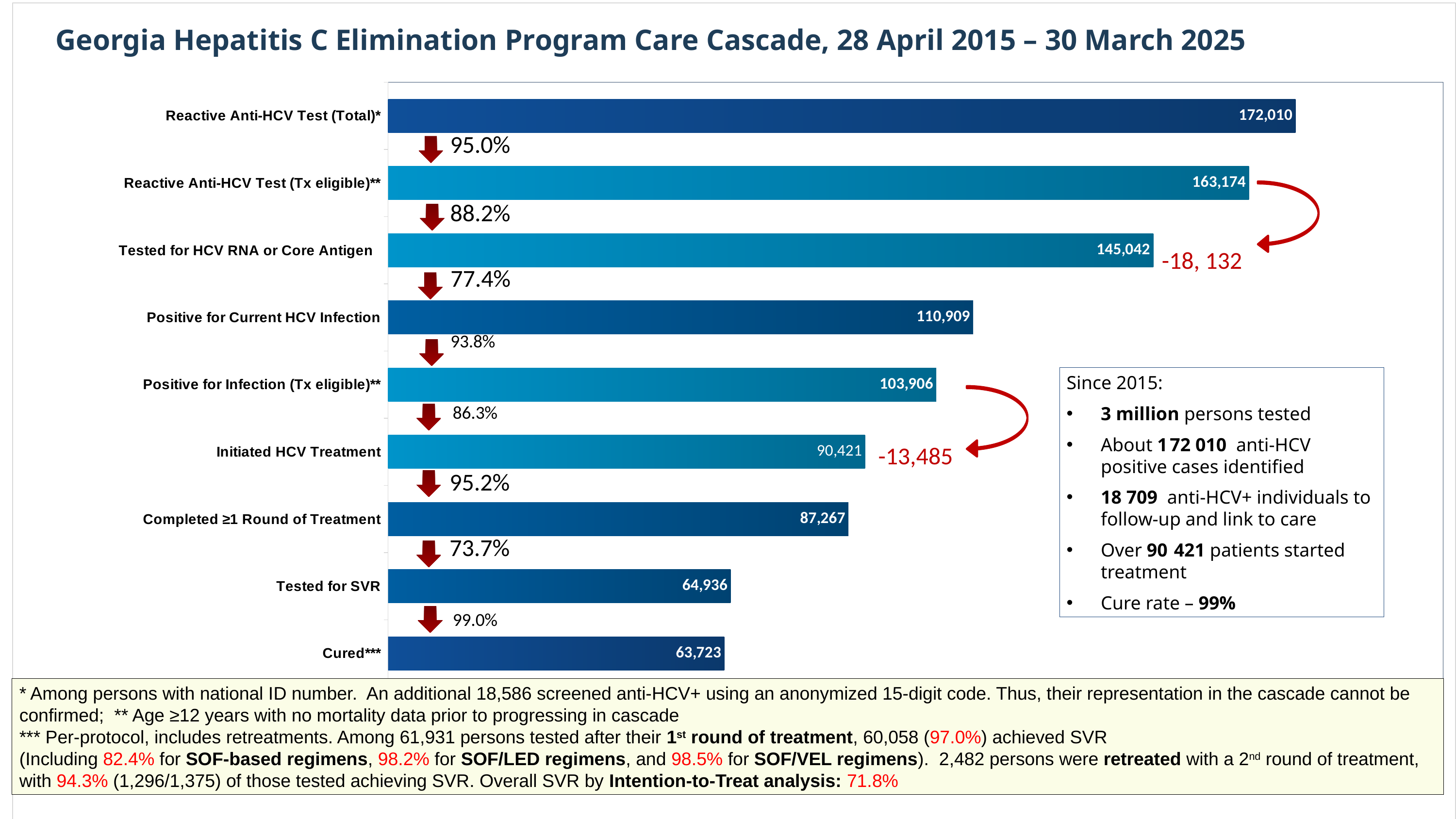
What is the value for Tested for HCV RNA or Core Antigen? 145,042 How many categories (bars) does the chart show? 9 What is the difference between Tested for SVR and Cured***? 1,213 Which category has the highest value? Reactive Anti-HCV Test (Total)* What is the value for Cured***? 63,723 What kind of chart is shown on the slide? Bar chart What is the difference between Completed ≥1 Round of Treatment and Tested for SVR? 22,331 Which category has the lowest value? Cured*** What is the value for Reactive Anti-HCV Test (Total)*? 172,010 Which is larger, Positive for Current HCV Infection or Positive for Infection (Tx eligible)**? Positive for Current HCV Infection What is the value for Initiated HCV Treatment? 90,421 What percentage is shown by the arrow between Tested for SVR and Cured***? 99.0%